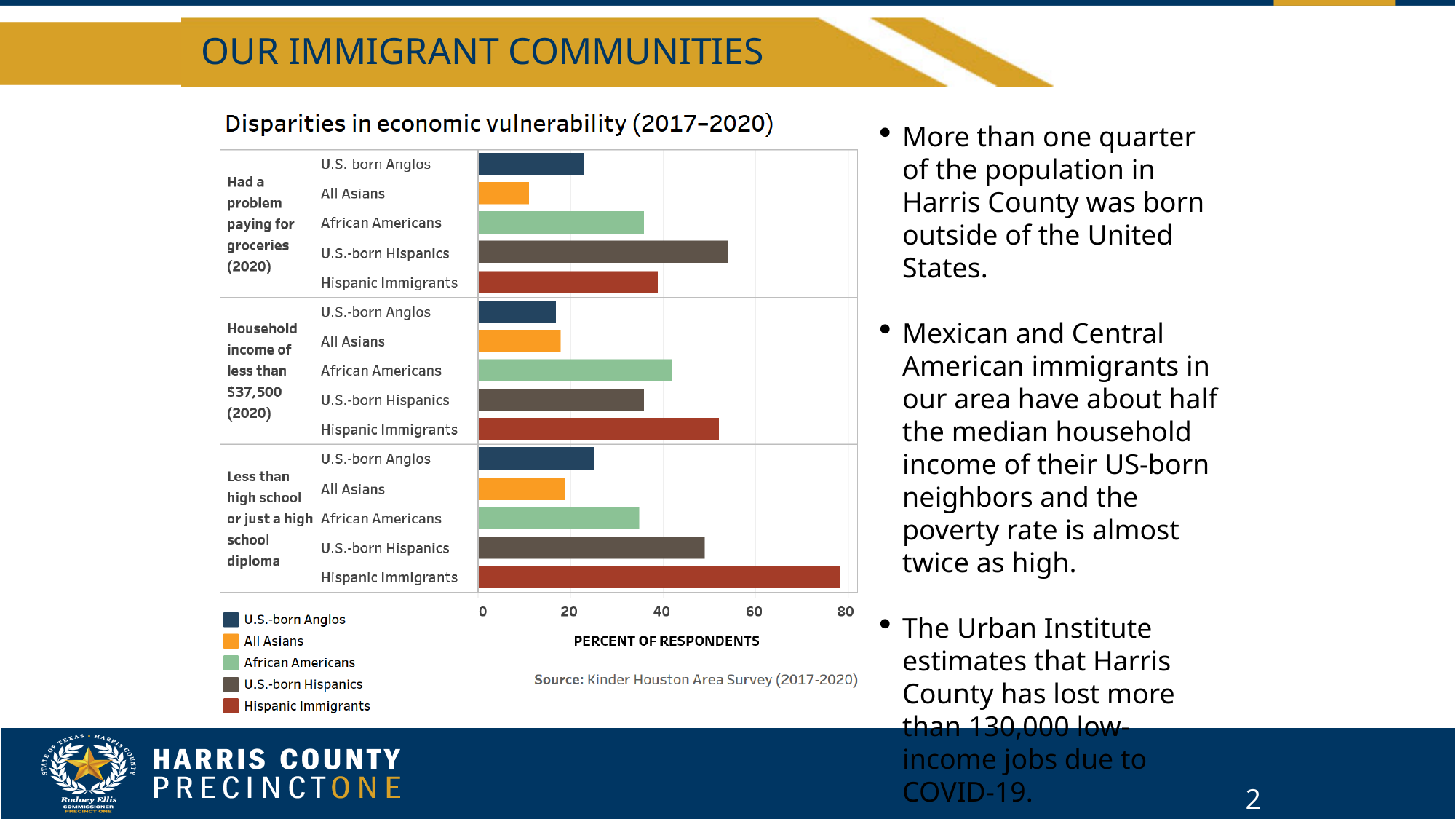
In the 'Household income of less than $37,500 (2020)' group, which population has the highest percentage? Hispanic Immigrants How many groups does the legend of the chart list? 5 What kind of chart is shown on the slide? bar chart How many question categories (row groups) are shown on the chart? 3 In the 'Had a problem paying for groceries (2020)' group, which population has the lowest percentage? All Asians Is the value for Hispanic Immigrants in the 'Less than high school or just a high school diploma' group greater or less than 60? greater In the 'Had a problem paying for groceries (2020)' group, which population has the highest percentage? U.S.-born Hispanics Is the value for All Asians in the 'Had a problem paying for groceries (2020)' group greater or less than 20? less What is the label on the horizontal axis of the chart? PERCENT OF RESPONDENTS Is the value for U.S.-born Hispanics in the 'Had a problem paying for groceries (2020)' group greater or less than 40? greater In the 'Less than high school or just a high school diploma' group, which population has the highest percentage? Hispanic Immigrants In the 'Less than high school or just a high school diploma' group, which is larger: the value for U.S.-born Hispanics or the value for All Asians? U.S.-born Hispanics